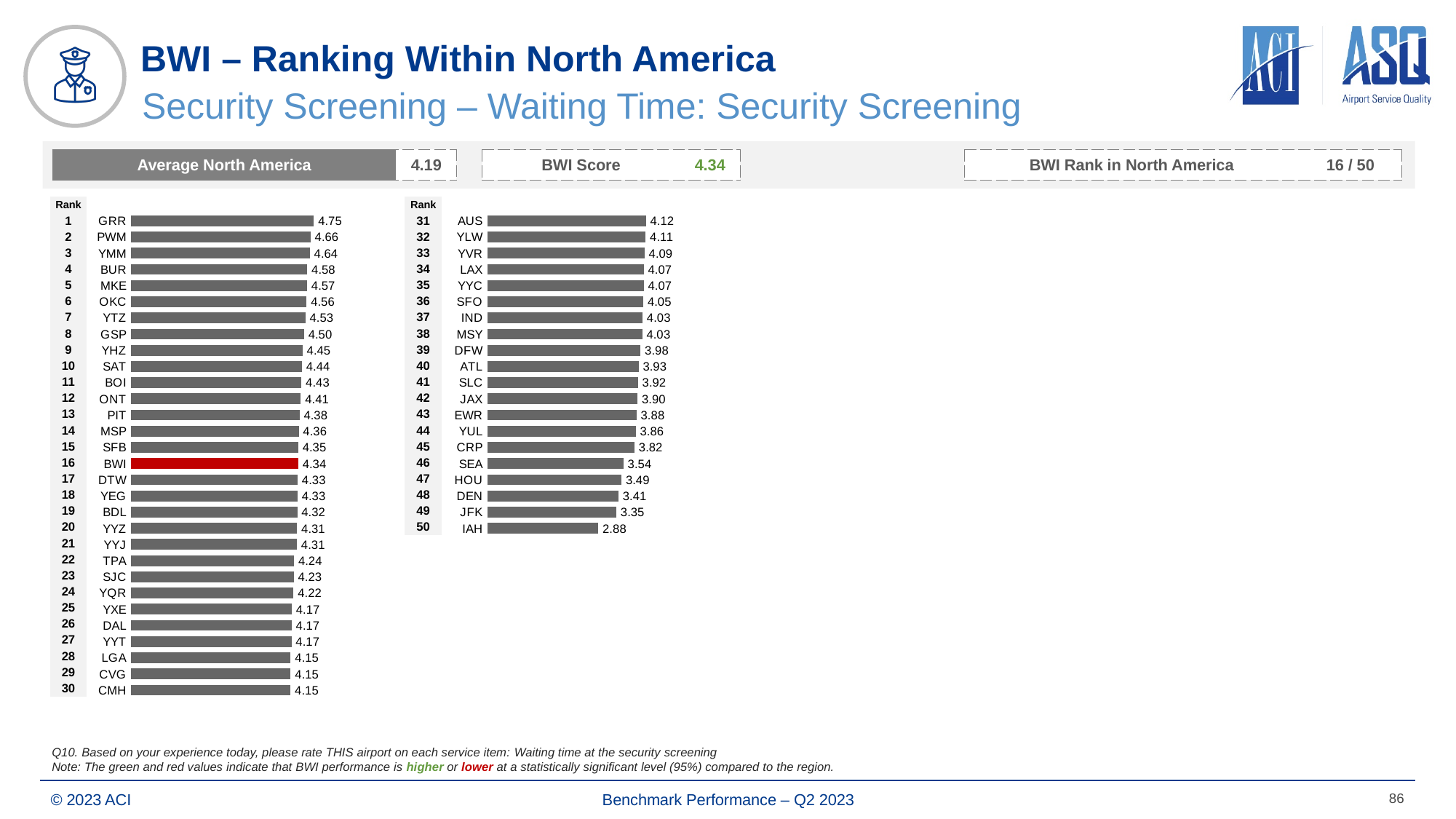
On the right chart (ranks 31–50), which has the higher score, DEN or JFK? DEN How many airports are shown on the left chart (ranks 1–30)? 30 On the right chart (ranks 31–50), what is the score for IAH? 2.88 On the left chart (ranks 1–30), what is the difference between the scores of GRR and BWI? 0.41 On the right chart (ranks 31–50), what is the difference between the scores of AUS and IAH? 1.24 On the left chart (ranks 1–30), which airport has the highest score? GRR On the left chart (ranks 1–30), which airport's bar is highlighted in red? BWI On the right chart (ranks 31–50), what is the score for SEA? 3.54 On the left chart (ranks 1–30), what is the score for GRR? 4.75 What kind of chart is used to show the airport scores on this slide? Bar chart On the left chart (ranks 1–30), what is the score for BWI? 4.34 On the right chart (ranks 31–50), which airport has the lowest score? IAH